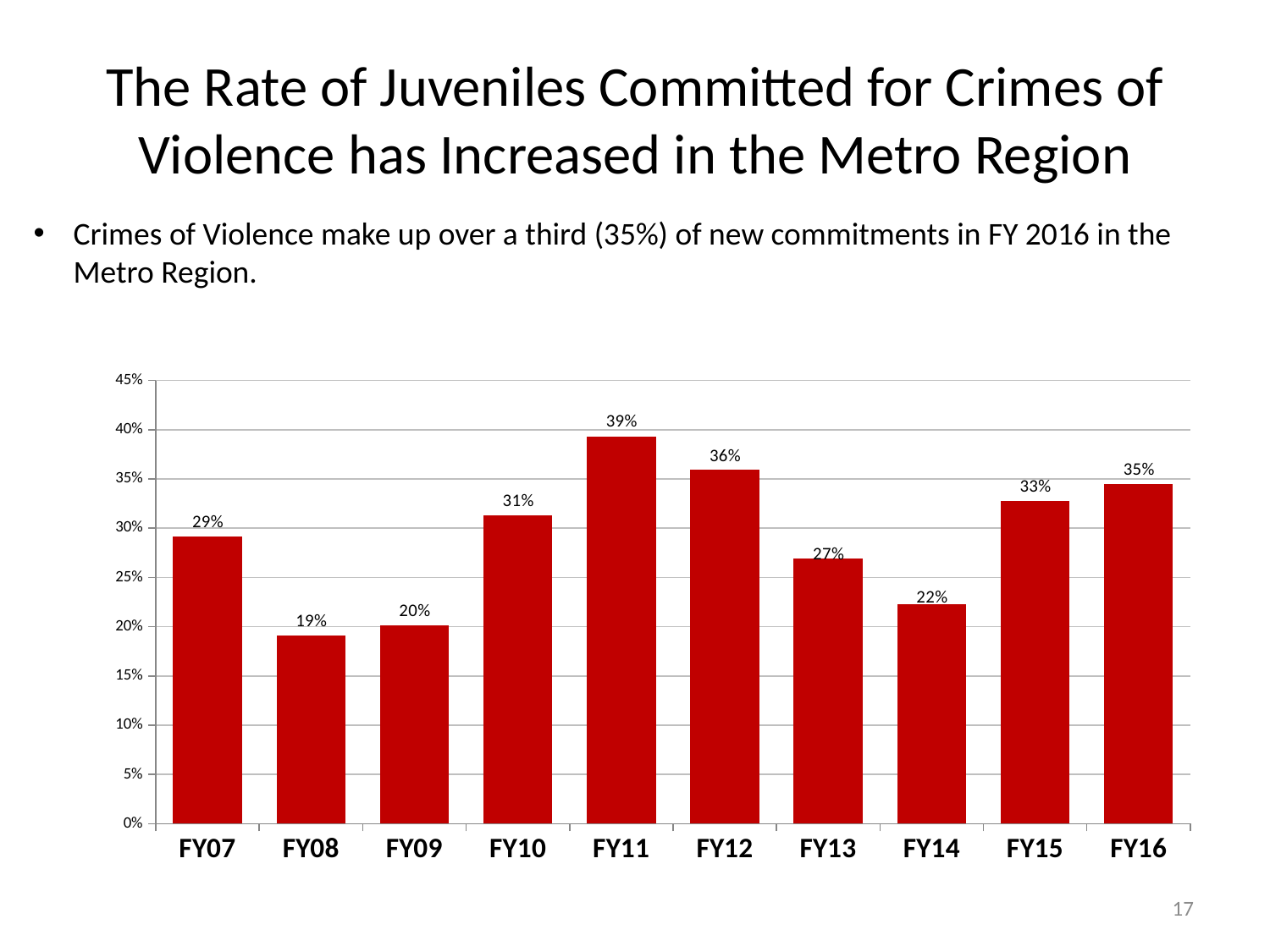
What kind of chart is shown on the slide? Bar chart Do the values rise or fall from FY13 to FY14? Fall How many fiscal years are shown on the x axis? 10 What is the difference between the values for FY11 and FY14? 17% What is the difference between the values for FY16 and FY07? 6% Is the value for FY10 greater or less than 30%? greater What is the value for FY11? 39% What is the value for FY16? 35% Which fiscal year has the highest value? FY11 What is the value for FY08? 19% Which fiscal year has the lowest value? FY08 Which is larger, the value for FY12 or the value for FY13? FY12